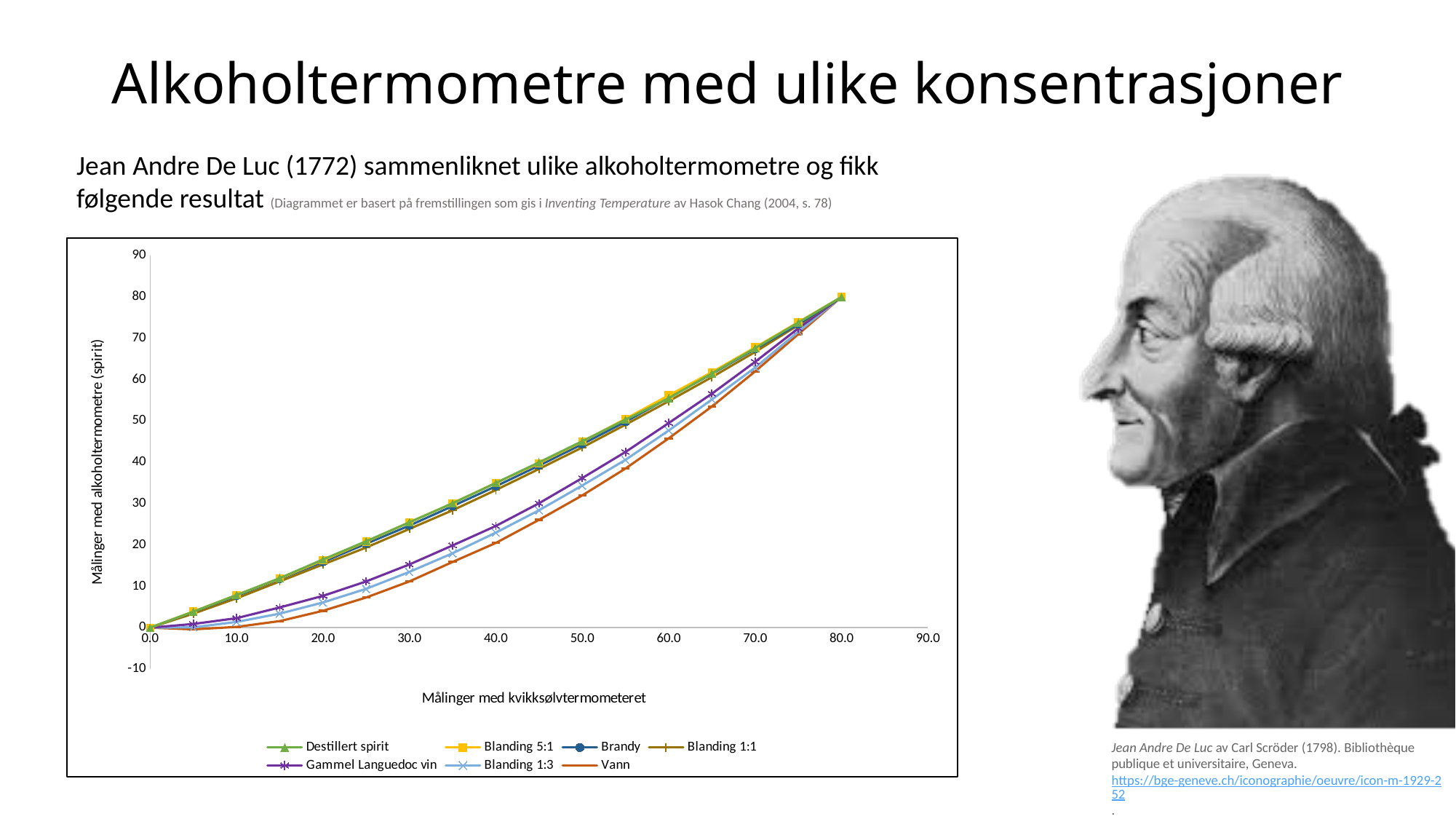
Is the value for Vann at 60.0 greater or less than 40? greater Is the value for Vann at 20.0 greater or less than 10? less At 50.0 on the x axis, which is larger: Destillert spirit or Vann? Destillert spirit At 40.0 on the x axis, which series has the lowest value? Vann How many series does the chart legend list? 7 What is the value of the Vann series at 80.0 on the x axis? 80 Is the value for Gammel Languedoc vin at 50.0 greater or less than 40? less What is the value of the Destillert spirit series at 0.0 on the x axis? 0 What is the title of the x axis? Målinger med kvikksølvtermometeret Do the values of the Vann series rise or fall as the x axis increases? rise What kind of chart is shown on the slide? line chart